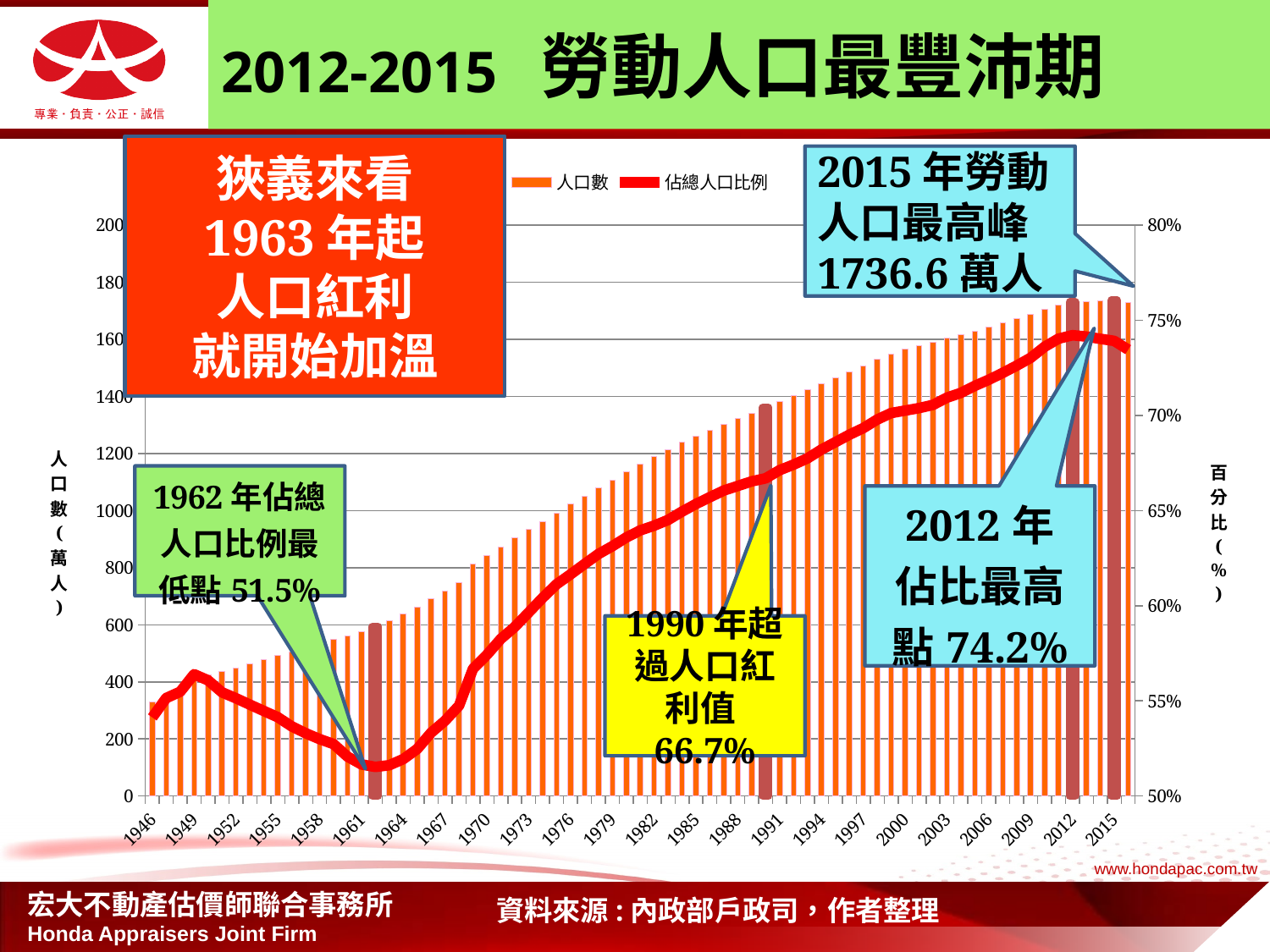
What value did the share of total population exceed in 1990, according to the callout? 66.7% What kind of chart is shown on the slide? Combined bar and line chart Do the 人口數 bars generally rise or fall from 1946 to 2015? rise Is the 佔總人口比例 value for 2015 greater or less than 70%? greater According to the callout, what was the lowest share of total population, in 1962? 51.5% According to the callout, what was the peak labour population in 2015? 1736.6 萬人 Is the 人口數 value for 1946 greater or less than 400? less In which year does the 佔總人口比例 line reach its lowest point? 1962 How many series does the chart legend list? 2 In which year does the 人口數 bar reach its highest value? 2015 According to the callout, what was the highest share of total population (佔總人口比例), reached in 2012? 74.2% Which year has a higher 佔總人口比例 value, 1949 or 1962? 1949